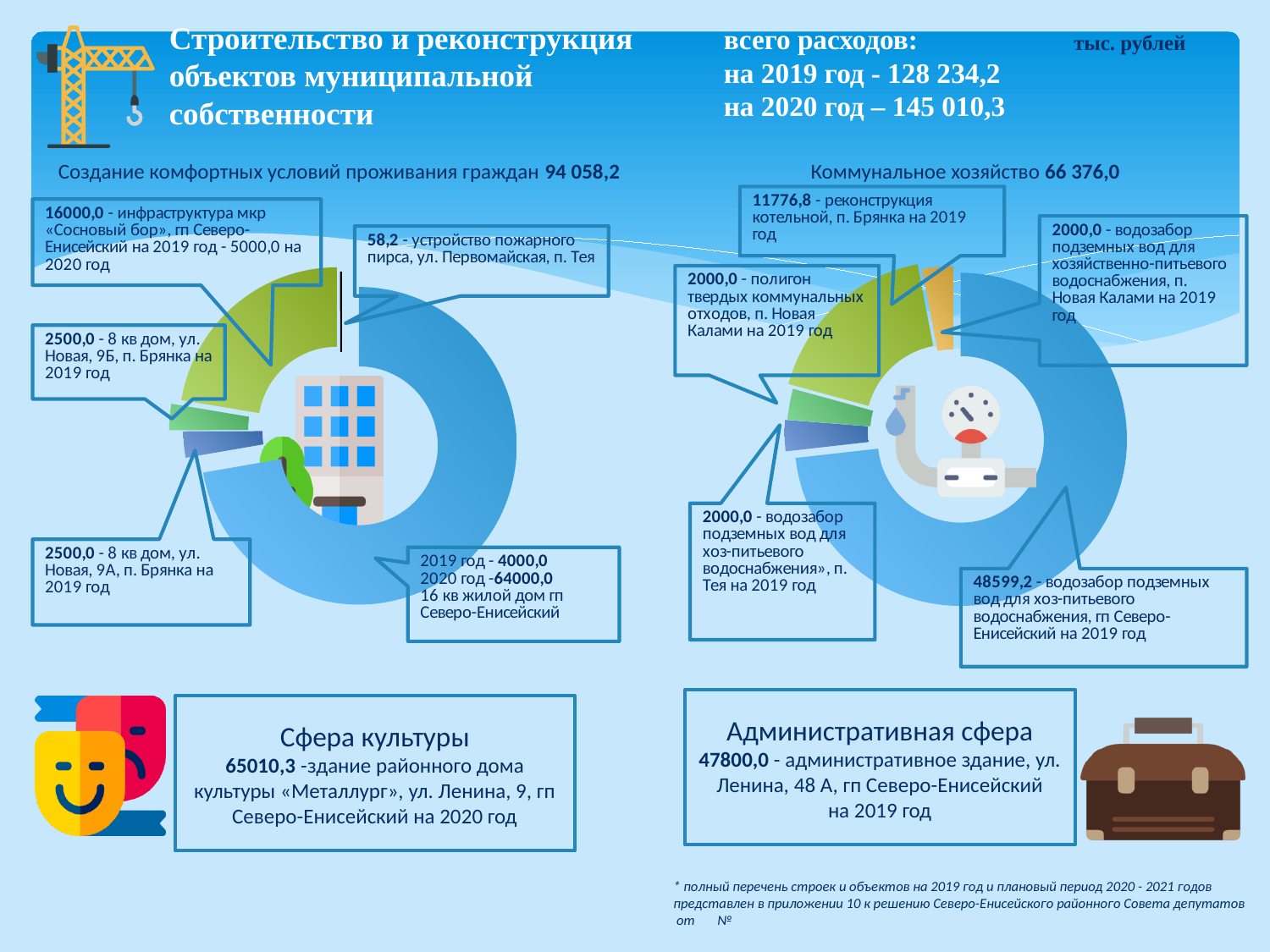
In the left chart ('Создание комфортных условий проживания граждан'), what is the value for the fire pier (устройство пожарного пирса, ул. Первомайская, п. Тея)? 58,2 In the left chart, which item has the smallest value? Устройство пожарного пирса, ул. Первомайская, п. Тея (58,2) In the left chart, what is the difference between the 2019 value for мкр «Сосновый бор» infrastructure (16000,0) and the 8-apartment house at ул. Новая, 9Б (2500,0)? 13500,0 In the left chart, what is the 2019 value for the infrastructure of мкр «Сосновый бор», гп Северо-Енисейский? 5000,0 In the right chart, which item has the largest value? Водозабор подземных вод для хоз-питьевого водоснабжения, гп Северо-Енисейский (48599,2) In the right chart ('Коммунальное хозяйство'), what is the value for the boiler house reconstruction (реконструкция котельной, п. Брянка) in 2019? 11776,8 How many labelled items (callouts) does the right chart 'Коммунальное хозяйство' have? 5 In the right chart, what is the difference between the water intake in гп Северо-Енисейский (48599,2) and the boiler house reconstruction in п. Брянка (11776,8)? 36822,4 What kind of chart is used for the 'Создание комфортных условий проживания граждан' section on the left? Pie (donut) chart What is the total shown for the 'Коммунальное хозяйство' section on the right chart? 66 376,0 In the right chart, which is larger: the boiler house reconstruction in п. Брянка or the solid waste landfill (полигон твердых коммунальных отходов) in п. Новая Калами? Boiler house reconstruction in п. Брянка (11776,8) In the left chart, what is the 2020 value for the 16-apartment residential house (16 кв жилой дом) in гп Северо-Енисейский? 64000,0